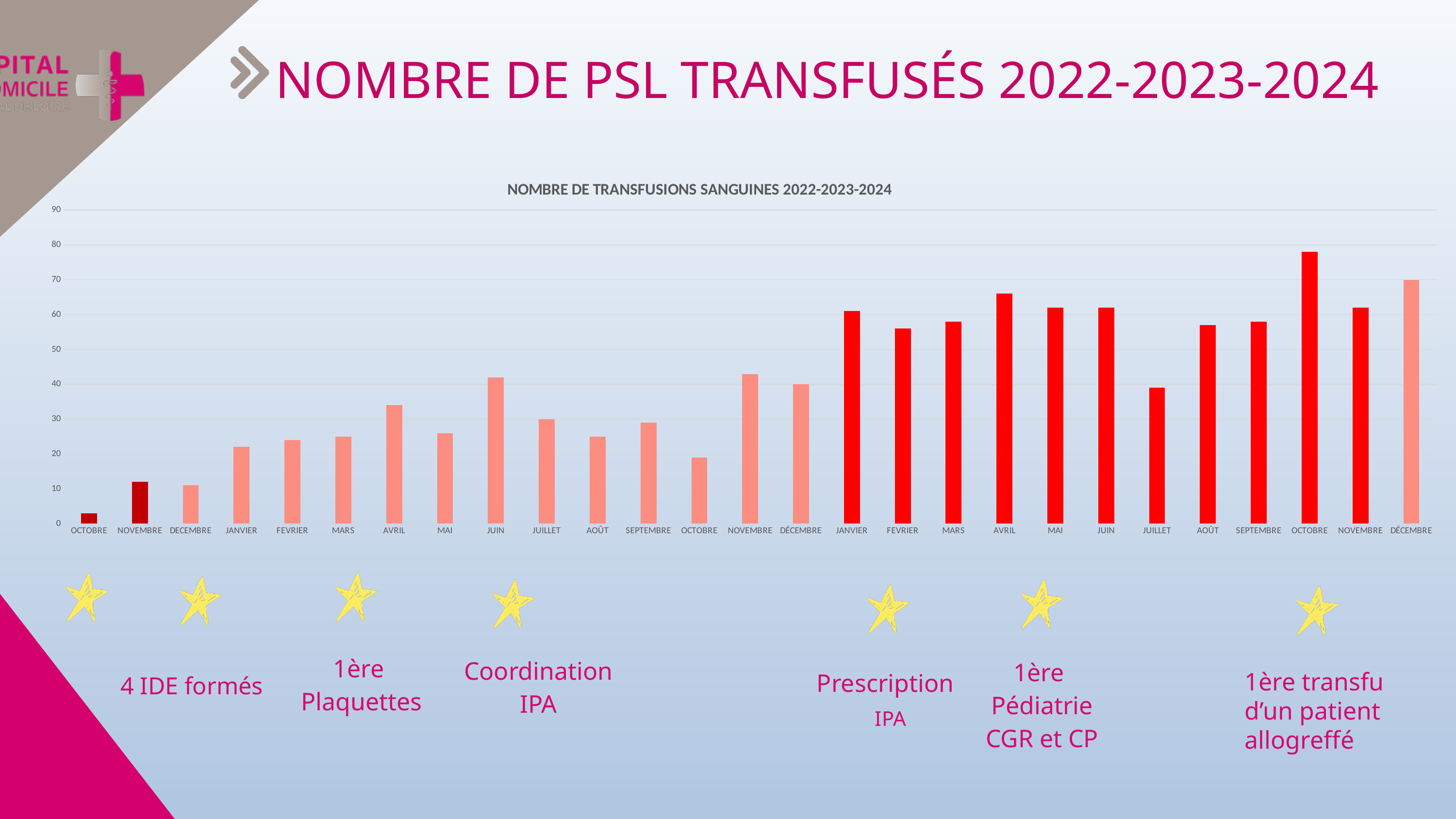
Is the value for the second JUILLET bar (the bright red one) greater or less than 50? less Is the value for the first OCTOBRE bar (leftmost) greater or less than 10? less How many bars are plotted in the chart? 27 Which is larger: the first JUIN bar (light red) or the second JUIN bar (bright red)? the second JUIN bar Is the value for the second AVRIL bar (the bright red one) greater or less than 60? greater Do the values generally rise or fall from left to right along the x axis? rise Which bar is the highest in the chart? the third OCTOBRE bar (the third bar from the right) What is the title of the chart? NOMBRE DE TRANSFUSIONS SANGUINES 2022-2023-2024 Which bar is the lowest in the chart? the first OCTOBRE bar (the leftmost bar) What is the highest value shown on the vertical axis? 90 What kind of chart is shown on the slide? bar chart